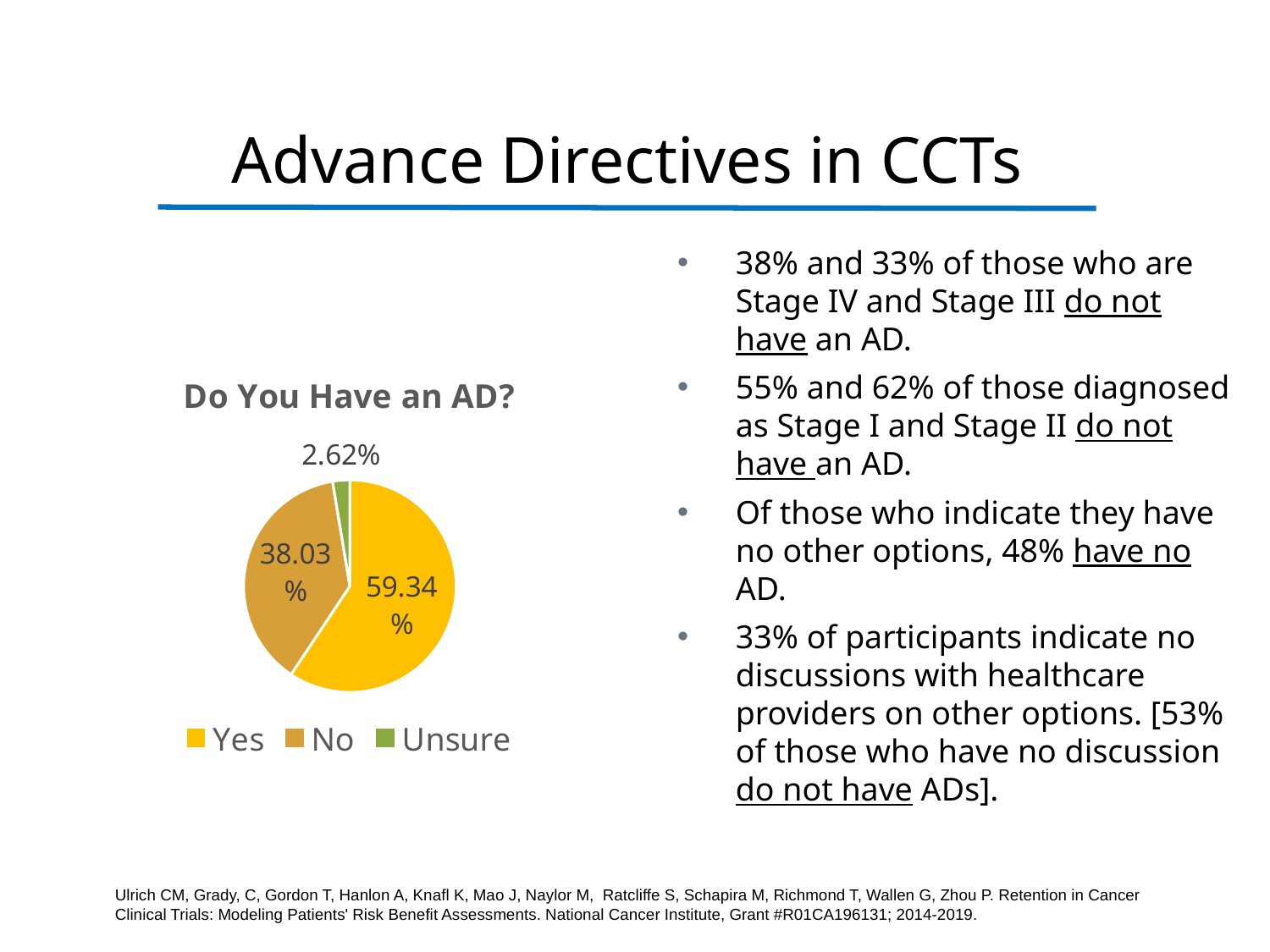
What is the difference in percentage points between the "Yes" and "No" slices? 21.31 What colour represents the "Unsure" category in the legend? green Which slice is larger, "Yes" or "No"? Yes How many categories does the legend list? 3 What percentage of the pie is labelled "Unsure"? 2.62% What type of chart is shown on the slide? pie chart What percentage of the pie is labelled "Yes"? 59.34% Which category has the smallest slice of the pie? Unsure What is the combined percentage of the "No" and "Unsure" slices? 40.65% What percentage of the pie is labelled "No"? 38.03% What is the title of the chart? Do You Have an AD? Which category has the largest slice of the pie? Yes